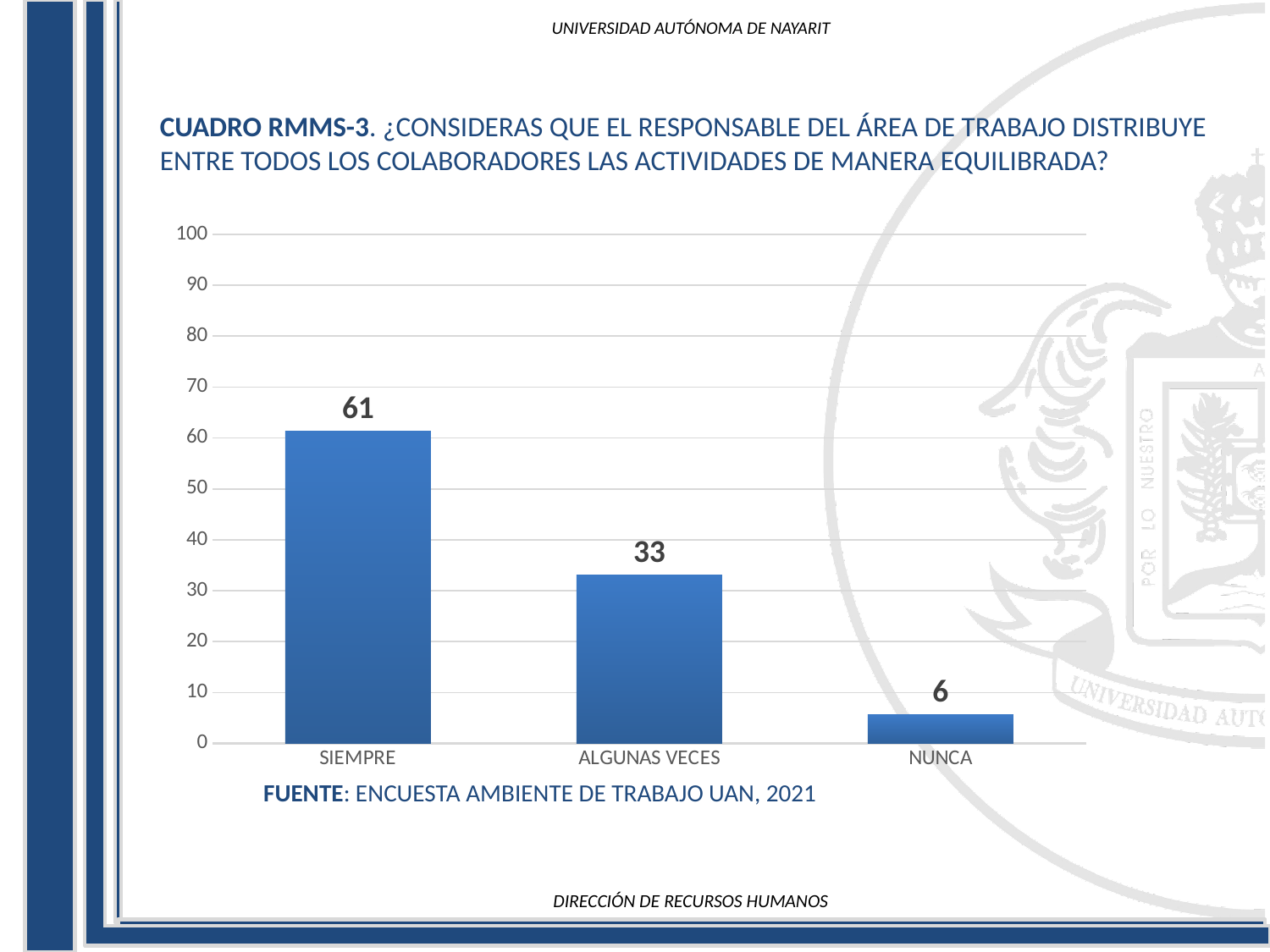
What is the source cited below the chart? ENCUESTA AMBIENTE DE TRABAJO UAN, 2021 Which category has the lowest value? NUNCA Which is larger, the value for ALGUNAS VECES or the value for NUNCA? ALGUNAS VECES What kind of chart is shown on the slide? bar chart Is the value for SIEMPRE greater or less than 50? greater What is the value for SIEMPRE? 61 What is the difference between the values for SIEMPRE and ALGUNAS VECES? 28 Which category has the highest value? SIEMPRE How many categories are shown on the x axis? 3 What is the value for NUNCA? 6 What is the value for ALGUNAS VECES? 33 What is the difference between the values for ALGUNAS VECES and NUNCA? 27